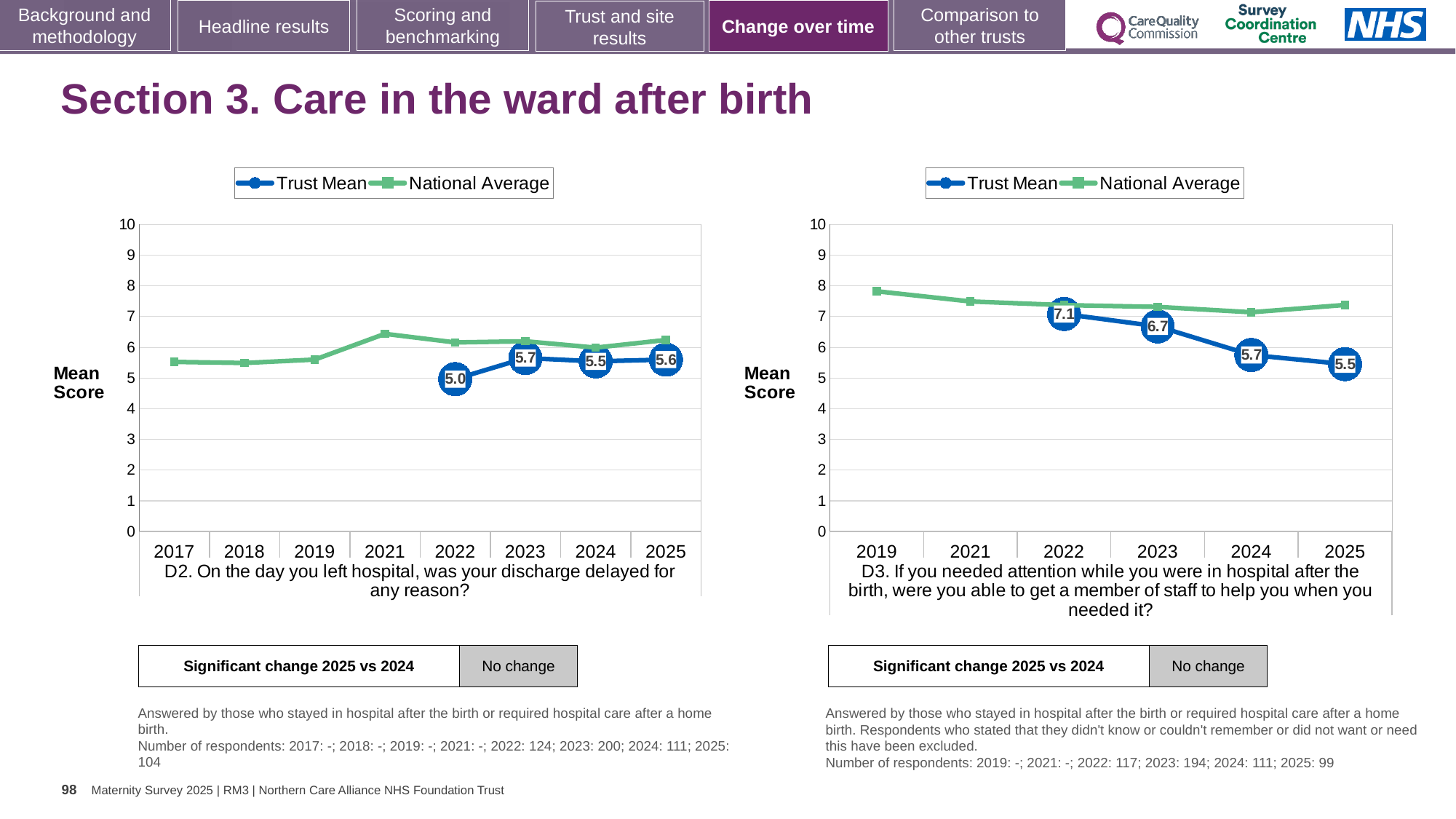
In the D3 chart (right), which is larger, the Trust Mean for 2022 or for 2024? 2022 In the D2 chart (left), is the National Average value for 2021 greater or less than 6? greater What kind of chart is the D3 chart (right)? line chart In the D2 chart (left), which year has the highest labelled Trust Mean value? 2023 In the D2 chart (left), what is the Trust Mean value for 2025? 5.6 In the D2 chart (left), how many years are shown on the x axis? 8 In the D3 chart (right), what is the Trust Mean value for 2023? 6.7 In the D2 chart (left), what is the Trust Mean value for 2022? 5.0 In the D2 chart (left), what is the difference between the Trust Mean values for 2023 and 2022? 0.7 In the D3 chart (right), does the Trust Mean rise or fall from 2022 to 2025? fall In the D3 chart (right), which year has the lowest labelled Trust Mean value? 2025 In the D3 chart (right), how many series does the legend list? 2